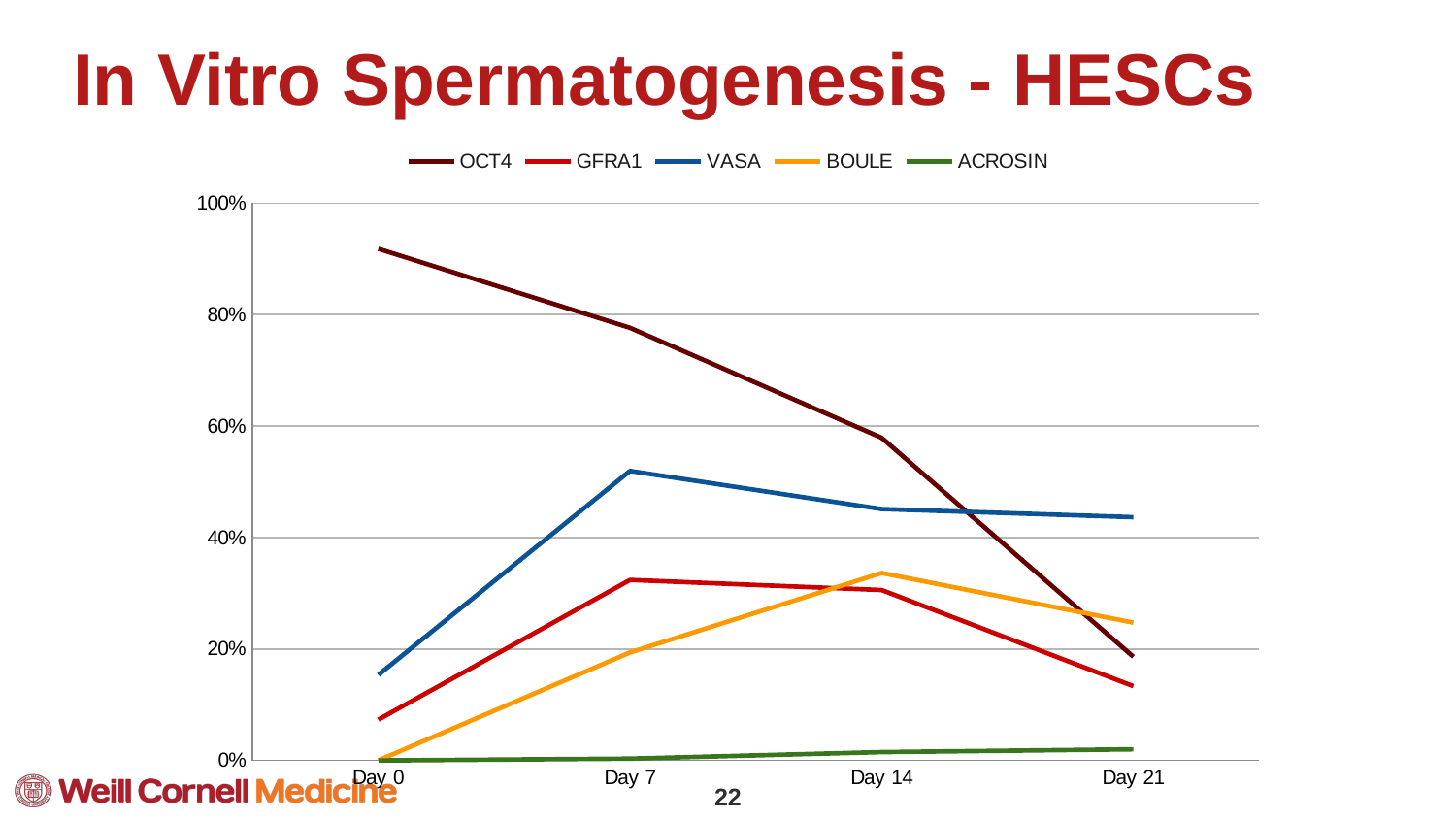
How many series does the legend list? 5 Which series has the highest value at Day 21? VASA Is the value for VASA at Day 7 greater or less than 40%? greater Does the OCT4 line rise or fall from Day 0 to Day 21? Fall At Day 7, which is larger: OCT4 or VASA? OCT4 Which series has the lowest value at Day 21? ACROSIN What kind of chart is shown on the slide? Line chart What is the title of the slide containing the chart? In Vitro Spermatogenesis - HESCs How many time points are plotted along the x axis? 4 Is the value for GFRA1 at Day 0 greater or less than 20%? less Which series has the highest value at Day 0? OCT4 Is the value for OCT4 at Day 0 greater or less than 80%? greater